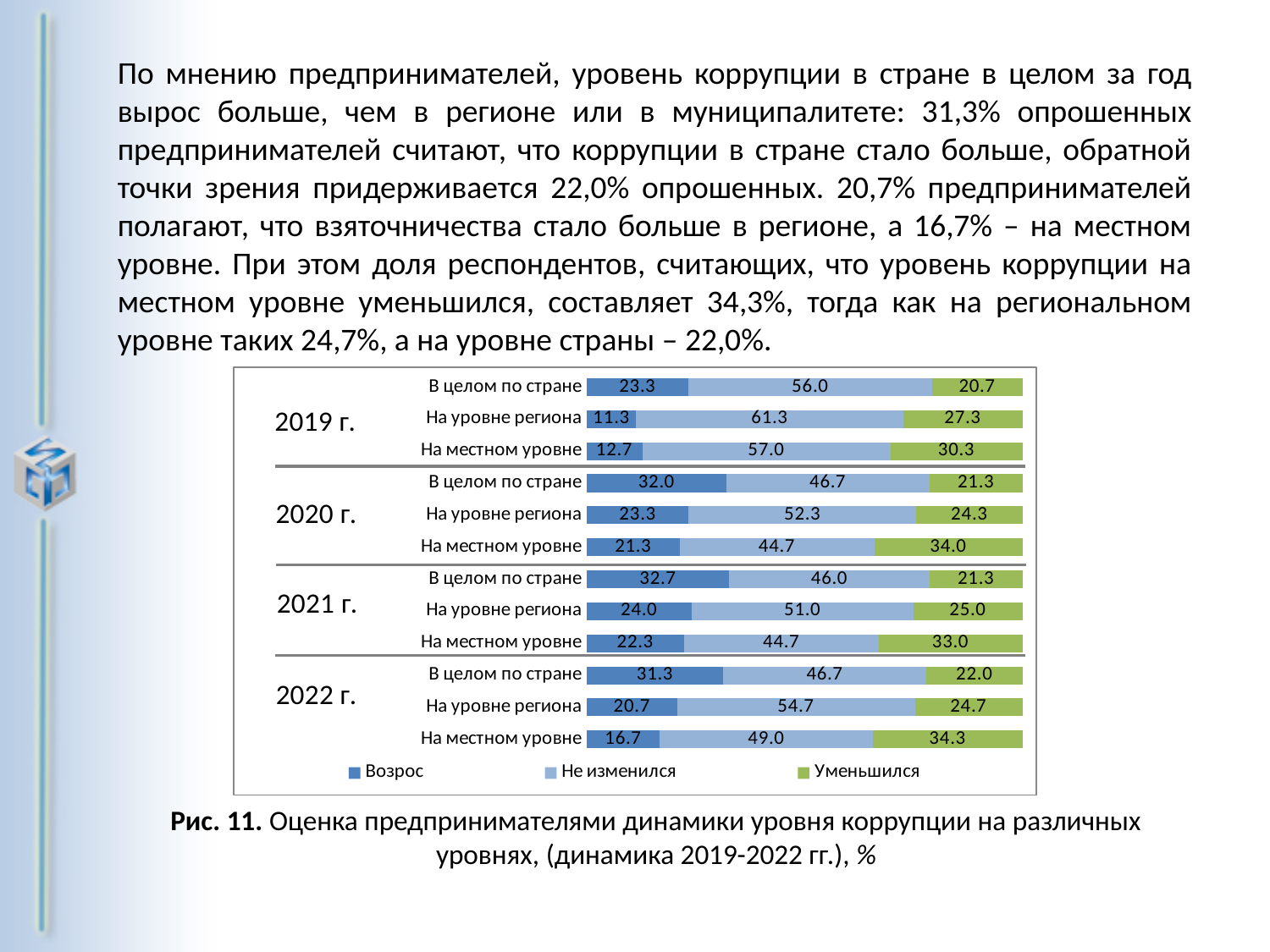
Which is larger: the 'Не изменился' value for 'На уровне региона' in 2020 or in 2021? 2020 (52.3) How many series does the legend list? 3 For 'На местном уровне' in 2022, what is the difference between the 'Уменьшился' and 'Возрос' values? 17.6 What is the value of the 'Уменьшился' segment for 'На местном уровне' in 2019? 30.3 How many bars are plotted in the chart? 12 Which bar has the lowest 'Возрос' value across all years and levels? На уровне региона, 2019 г. (11.3) What type of chart is shown on the slide? Stacked bar chart What is the value of the 'Не изменился' segment for 'На уровне региона' in 2021? 51.0 What is the total of the stacked bar for 'В целом по стране' in 2019? 100.0 What are the three legend entries of the chart? Возрос, Не изменился, Уменьшился What is the value of the 'Возрос' segment for 'В целом по стране' in 2022? 31.3 Which bar has the highest 'Возрос' value across all years and levels? В целом по стране, 2021 г. (32.7)